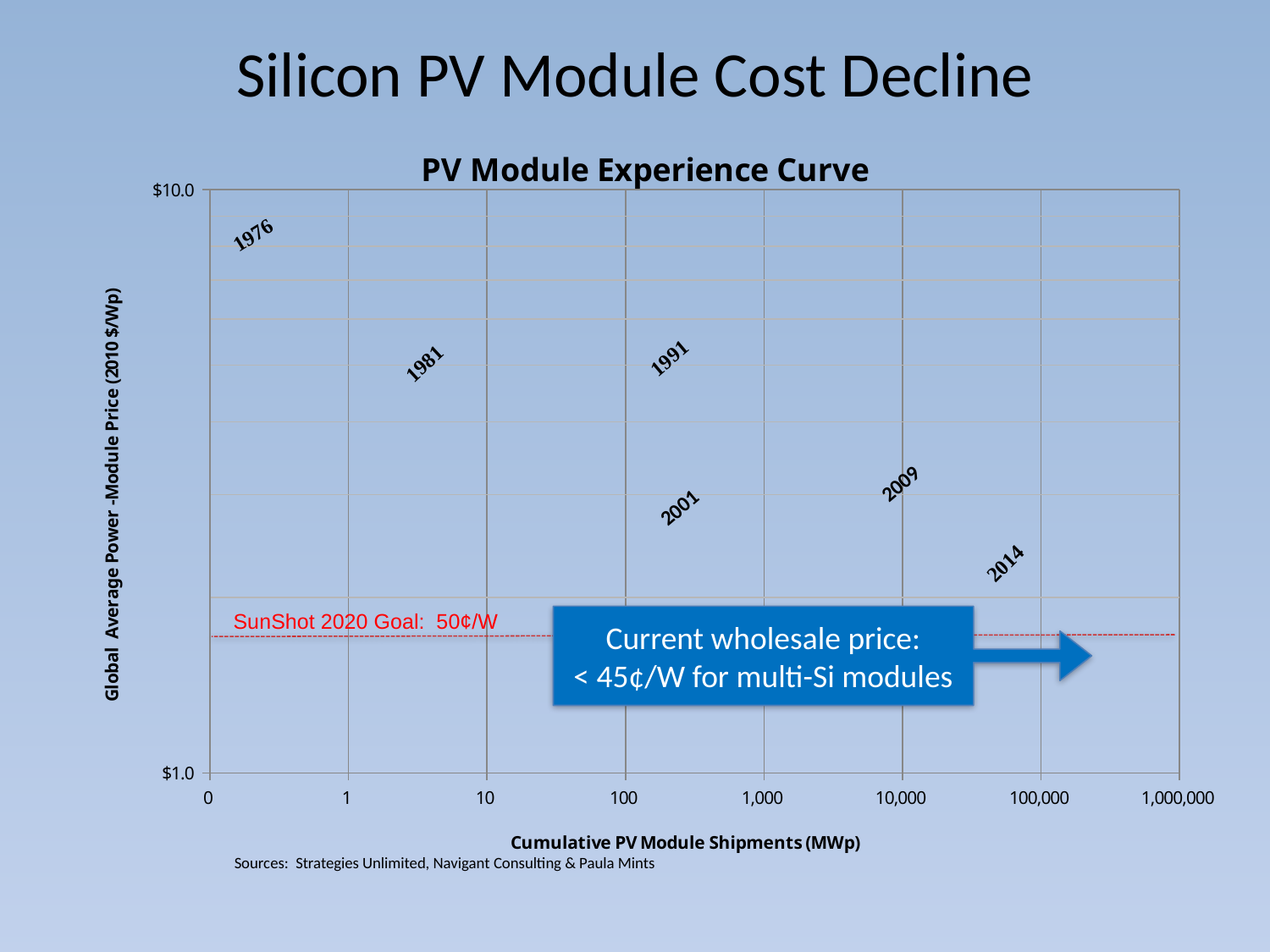
Is the cumulative shipments value for 2014 greater or less than 10,000 MWp? greater Which year has a higher module price, 2009 or 2014? 2009 What is the title of the chart? PV Module Experience Curve Which year has the highest module price on the chart? 1976 What is the SunShot 2020 Goal price marked on the chart? 50¢/W Which year has a higher module price, 1981 or 2001? 1981 Does the module price rise or fall as cumulative shipments increase along the x axis? fall Is the cumulative shipments value for 2009 greater or less than 1,000 MWp? greater How many year-labelled data points are plotted on the chart? 6 What is the label of the x axis of the chart? Cumulative PV Module Shipments (MWp) Is the cumulative shipments value for 1981 greater or less than 10 MWp? less Which year has the lowest module price on the chart? 2014